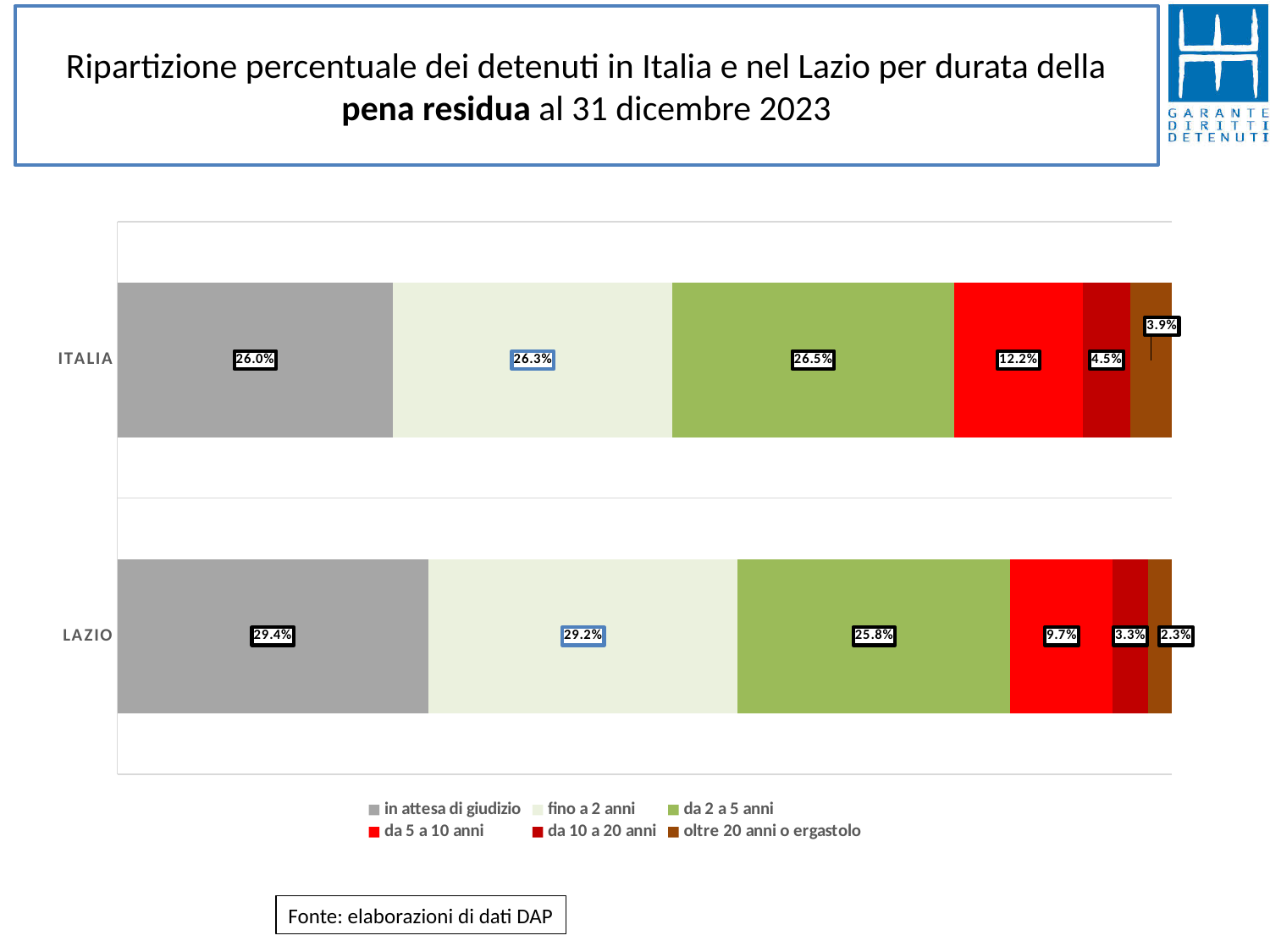
What is the value for 'oltre 20 anni o ergastolo' for ITALIA? 3.9% What is the value for 'da 5 a 10 anni' for LAZIO? 9.7% Which series has the lowest value for LAZIO? oltre 20 anni o ergastolo How many categories (bars) are shown on the chart? 2 What is the value for 'da 2 a 5 anni' for LAZIO? 25.8% What is the difference between the 'in attesa di giudizio' values for LAZIO and ITALIA? 3.4% Which is larger: 'da 10 a 20 anni' for ITALIA or for LAZIO? ITALIA What kind of chart is shown on the slide? Stacked bar chart What colour represents 'da 5 a 10 anni' in the chart? Red Which series has the highest value for ITALIA? da 2 a 5 anni What is the value for 'in attesa di giudizio' for ITALIA? 26.0% How many series does the legend list? 6